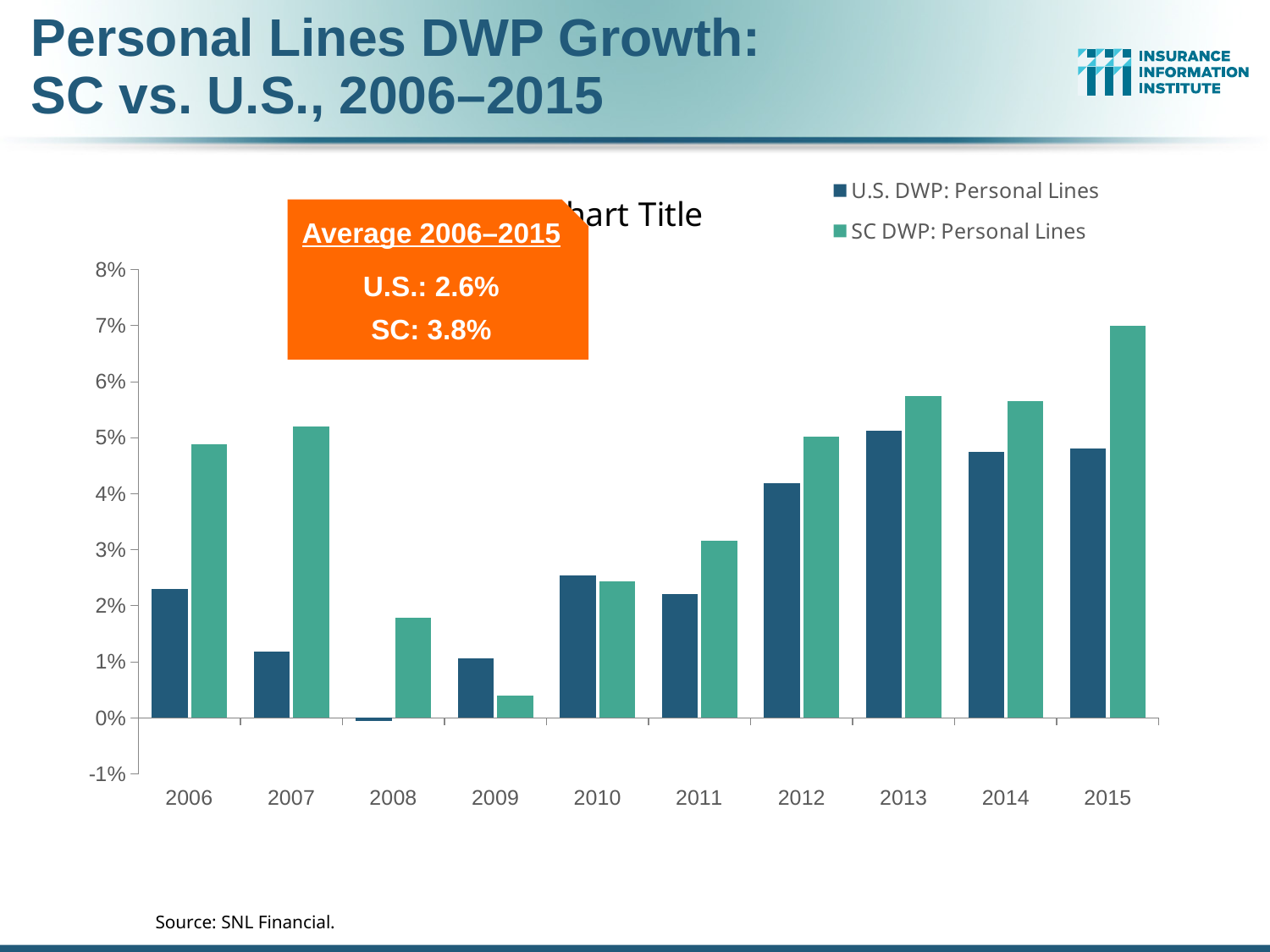
How many years are shown on the x axis? 10 In 2009, which is larger: U.S. DWP: Personal Lines or SC DWP: Personal Lines? U.S. DWP: Personal Lines Is the U.S. DWP: Personal Lines value for 2007 greater or less than 2%? less In which year is the U.S. DWP: Personal Lines growth lowest? 2008 How many series does the legend list? 2 Is the SC DWP: Personal Lines value for 2015 greater or less than 6%? greater In which year is the SC DWP: Personal Lines growth highest? 2015 Is the SC DWP: Personal Lines value for 2013 greater or less than 5%? greater In 2006, which is larger: U.S. DWP: Personal Lines or SC DWP: Personal Lines? SC DWP: Personal Lines According to the orange box, what is the SC average for 2006–2015? 3.8% In which year is the SC DWP: Personal Lines growth lowest? 2009 What kind of chart is shown on the slide? bar chart